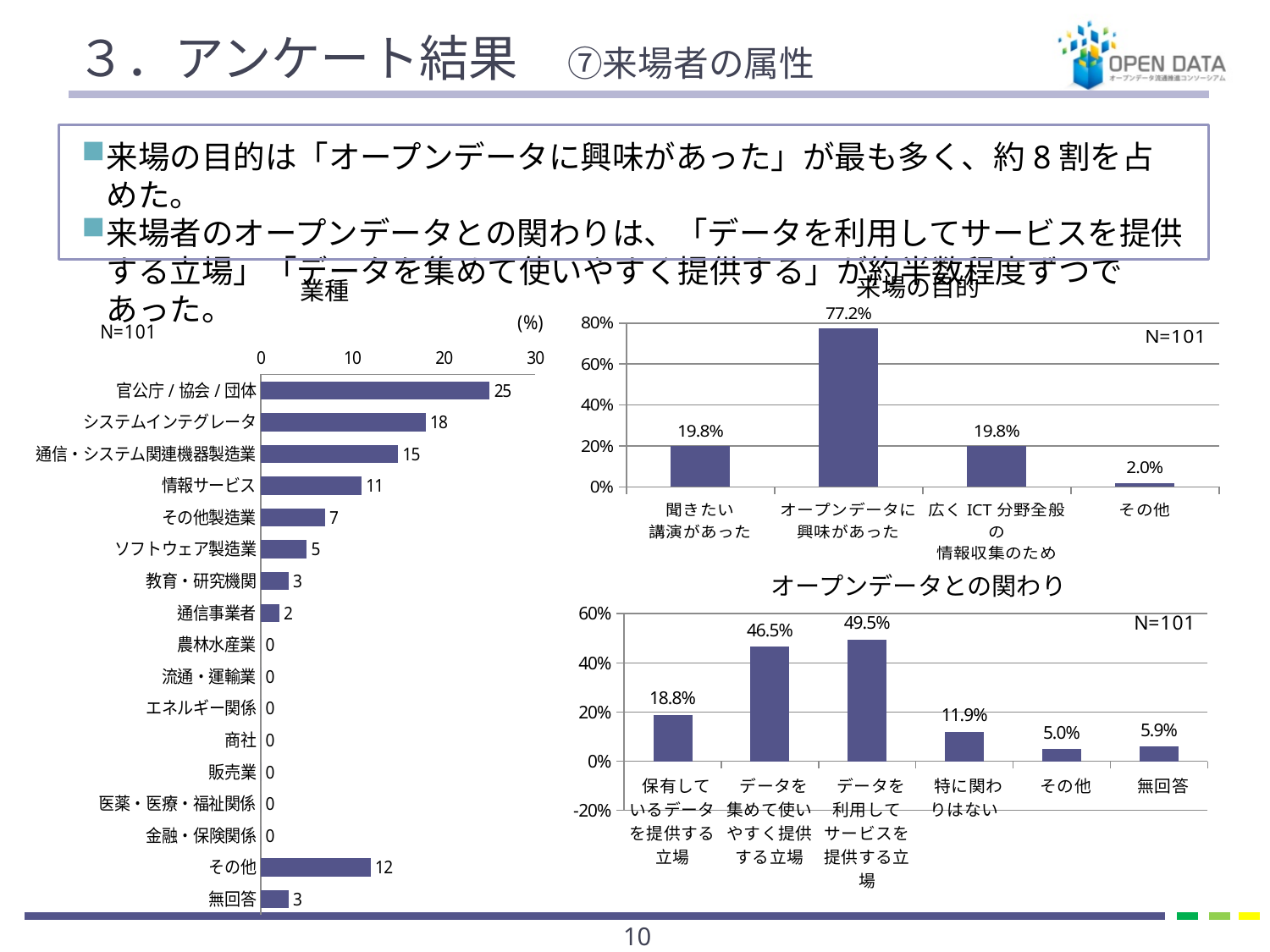
In the 来場の目的 chart, which category has the lowest value? その他 In the オープンデータとの関わり chart, which is larger: 特に関わりはない or 無回答? 特に関わりはない In the 来場の目的 chart, how many categories are shown? 4 In the 業種 chart, which category has the highest value? 官公庁 / 協会 / 団体 What kind of chart is the 業種 chart? Bar chart In the 業種 chart, what is the value for 情報サービス? 11 In the オープンデータとの関わり chart, what is the difference between データを利用してサービスを提供する立場 and データを集めて使いやすく提供する立場? 3.0% In the オープンデータとの関わり chart, what is the value for データを利用してサービスを提供する立場? 49.5% In the 業種 chart, what is the value for 官公庁 / 協会 / 団体? 25 In the 来場の目的 chart, what is the value for オープンデータに興味があった? 77.2% In the 業種 chart, how many categories are shown? 17 In the 業種 chart, what is the difference between システムインテグレータ and 通信・システム関連機器製造業? 3